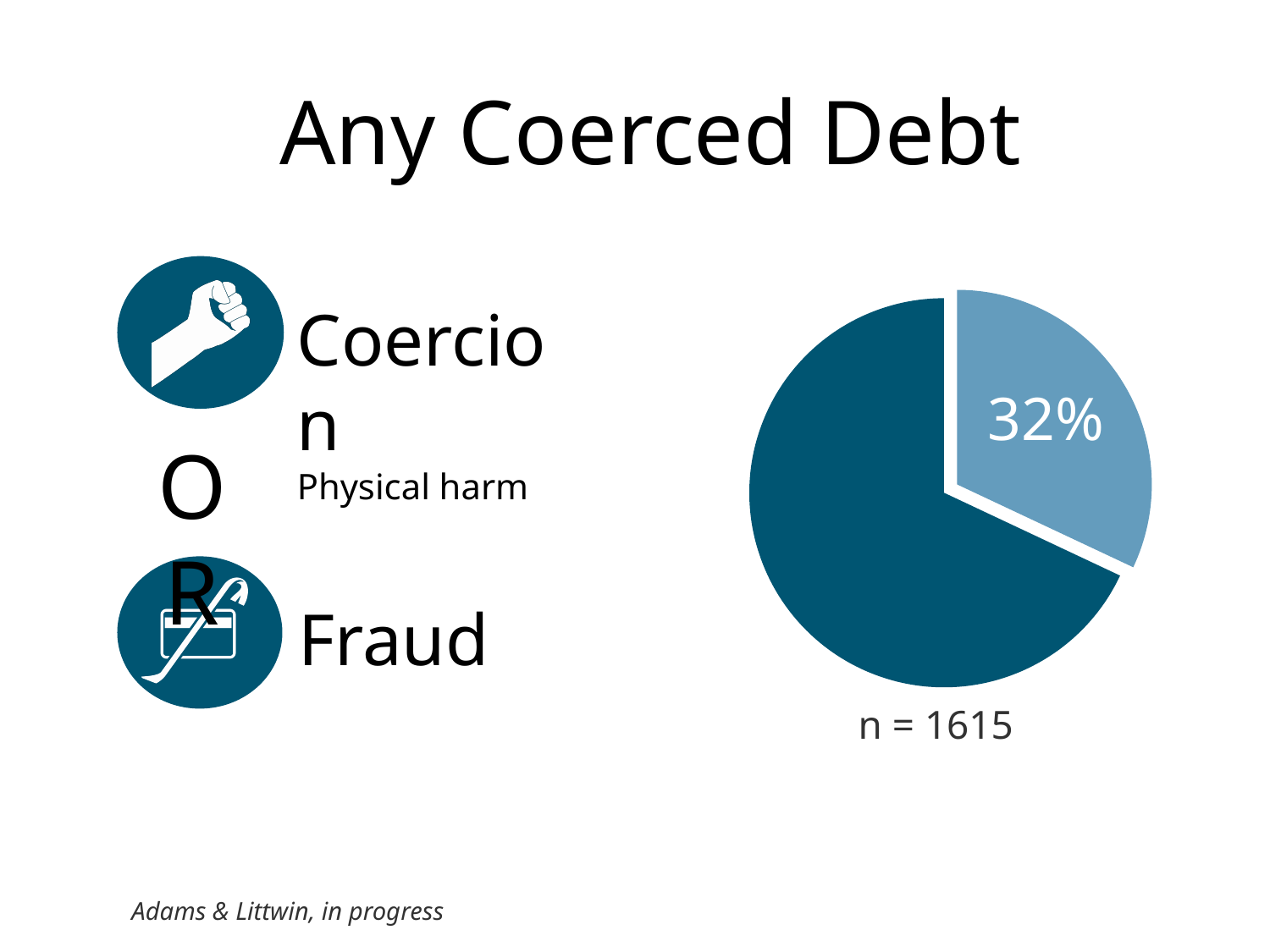
What percentage is printed on the light blue slice of the pie chart? 32% What is the title of the slide containing the pie chart? Any Coerced Debt Which slice of the pie chart is larger, the dark blue slice or the light blue slice? the dark blue slice What kind of chart is shown on the slide? pie chart What share of the pie does the labelled slice represent? 32% Which slice of the pie chart is the smallest? the light blue slice labelled 32% Is the labelled slice of the pie chart less than half of the pie? yes How many slices does the pie chart have? 2 What sample size (n) is shown below the pie chart? n = 1615